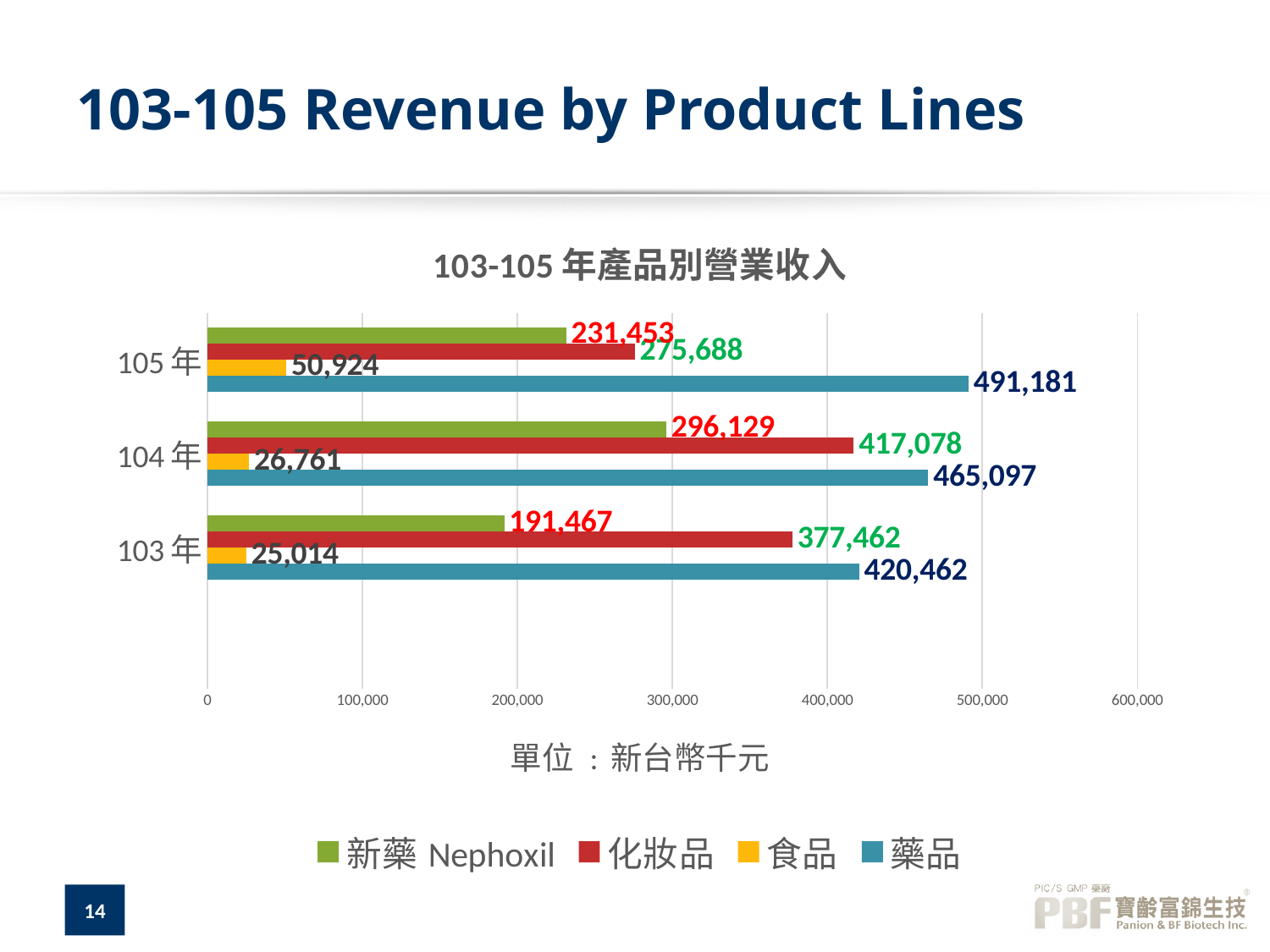
What kind of chart is shown on the slide? bar chart In which year is the 藥品 revenue highest? 105 年 What is the revenue for 藥品 in 105 年? 491,181 How many years are shown on the chart? 3 Which year has the larger 化妝品 revenue, 104 年 or 105 年? 104 年 Is the 化妝品 revenue in 103 年 greater or less than 400,000? less What is the revenue for 新藥 Nephoxil in 103 年? 191,467 What is the revenue for 食品 in 104 年? 26,761 Which product line has the lowest revenue in 103 年? 食品 What is the difference between the 藥品 revenue in 105 年 and in 104 年? 26,084 How many product lines does the legend list? 4 Does the 藥品 revenue rise or fall from 103 年 to 105 年? rise